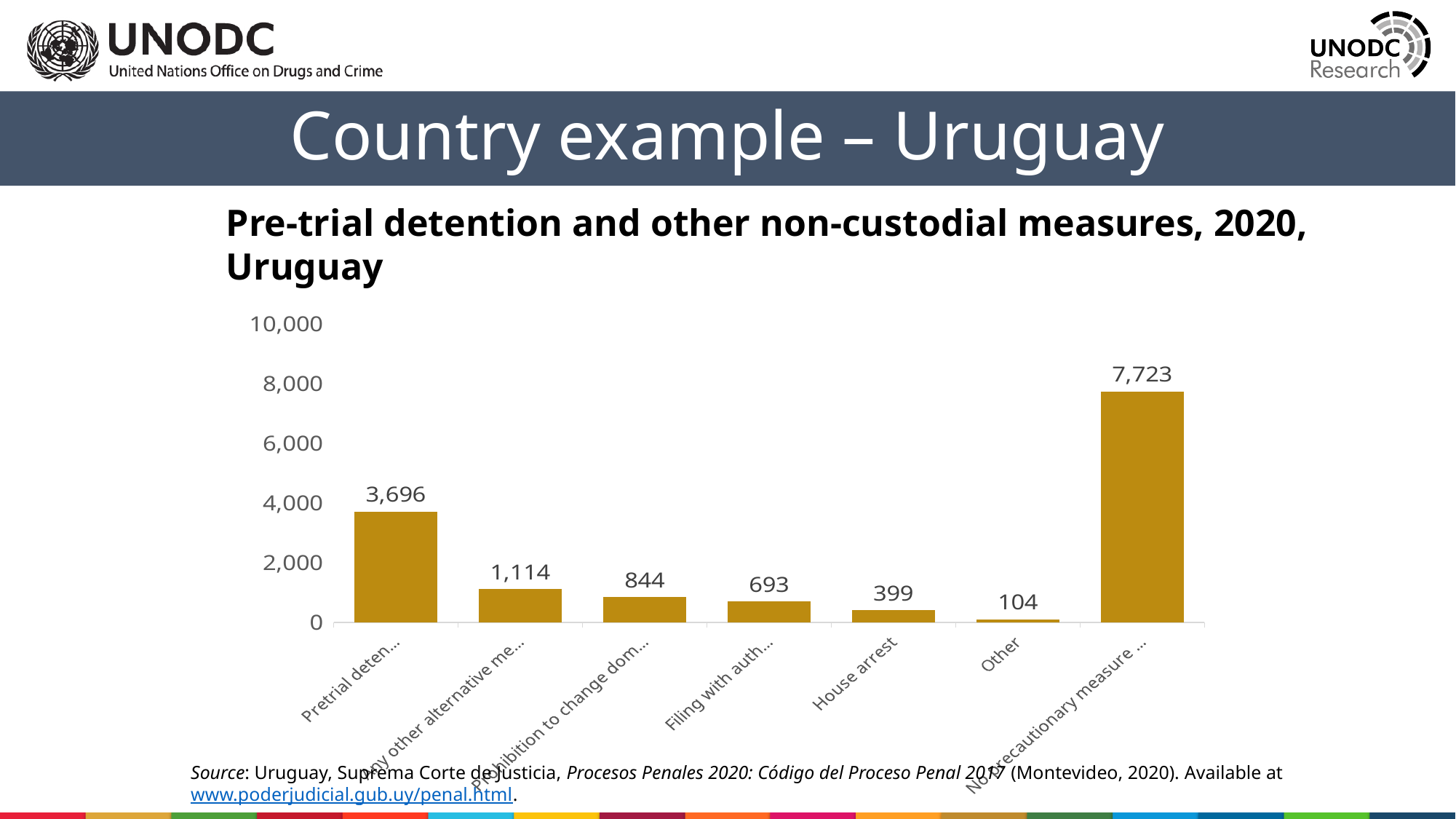
What kind of chart is shown on the slide? Bar chart What is the value shown for the bar labelled "Filing with auth..."? 693 What is the difference between the value for House arrest and the value for Other? 295 Which is larger, the value for House arrest or the value for Other? House arrest What is the difference between the value for "No precautionary measure ..." (7,723) and the value for "Pretrial deten..." (3,696)? 4,027 What is the value for the category labelled Other? 104 What is the title of the chart? Pre-trial detention and other non-custodial measures, 2020, Uruguay What is the value shown for the bar labelled "Pretrial deten..."? 3,696 Which category has the lowest value? Other Which category has the highest value? No precautionary measure What is the value for House arrest? 399 How many categories are shown on the x axis? 7